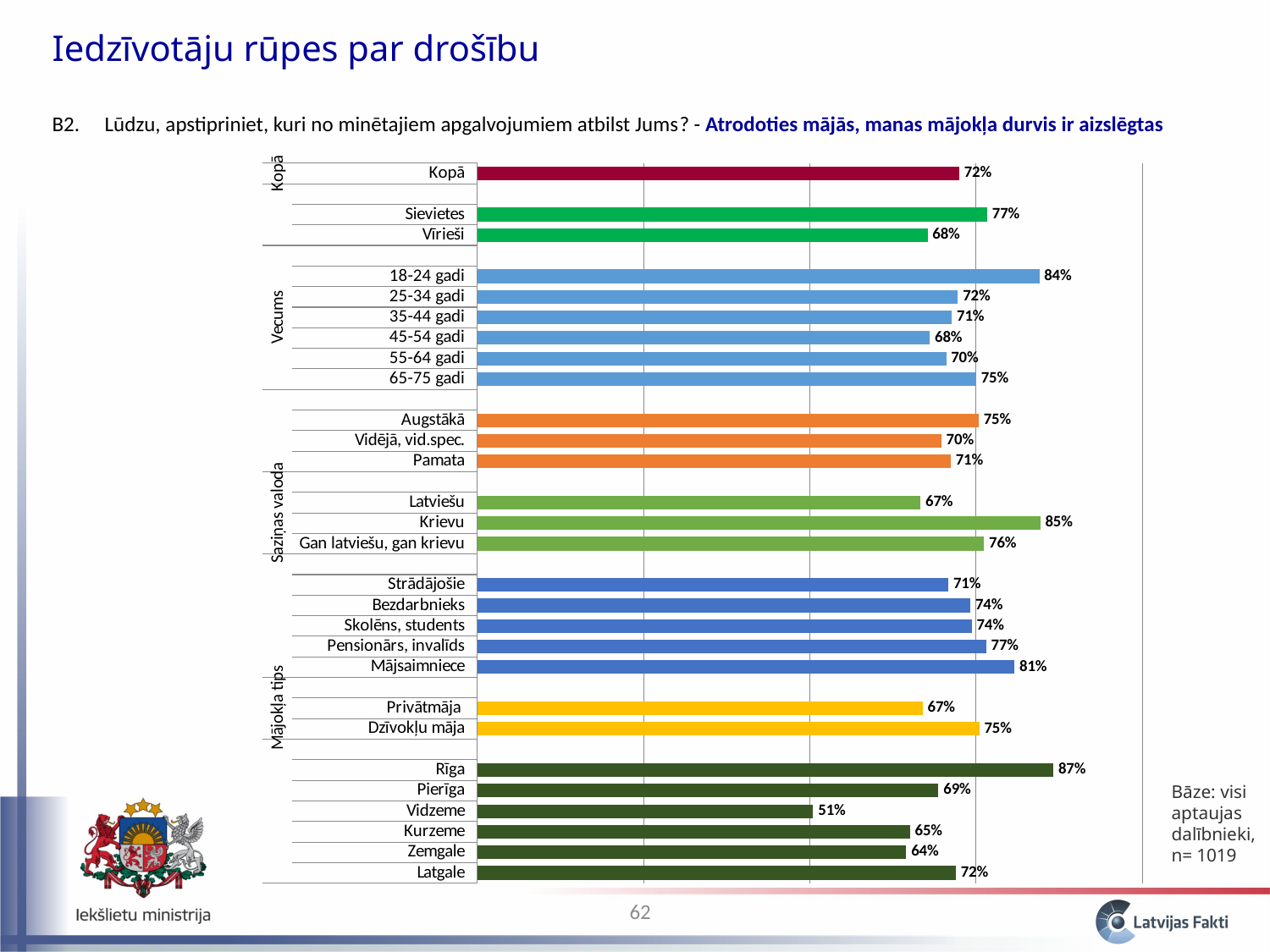
What kind of chart is shown on the slide? Bar chart What is the value for Sievietes? 77% Which category has the lowest value on the chart? Vidzeme How many bars are plotted on the chart? 28 What is the difference between the values for Sievietes and Vīrieši? 9 percentage points What is the value for Krievu? 85% What is the value for Kopā? 72% What is the difference between the values for Rīga and Vidzeme? 36 percentage points What is the value for 18-24 gadi? 84% Which is larger, the value for Privātmāja or Dzīvokļu māja? Dzīvokļu māja Which category has the highest value on the chart? Rīga Which is larger, the value for Latviešu or Gan latviešu, gan krievu? Gan latviešu, gan krievu